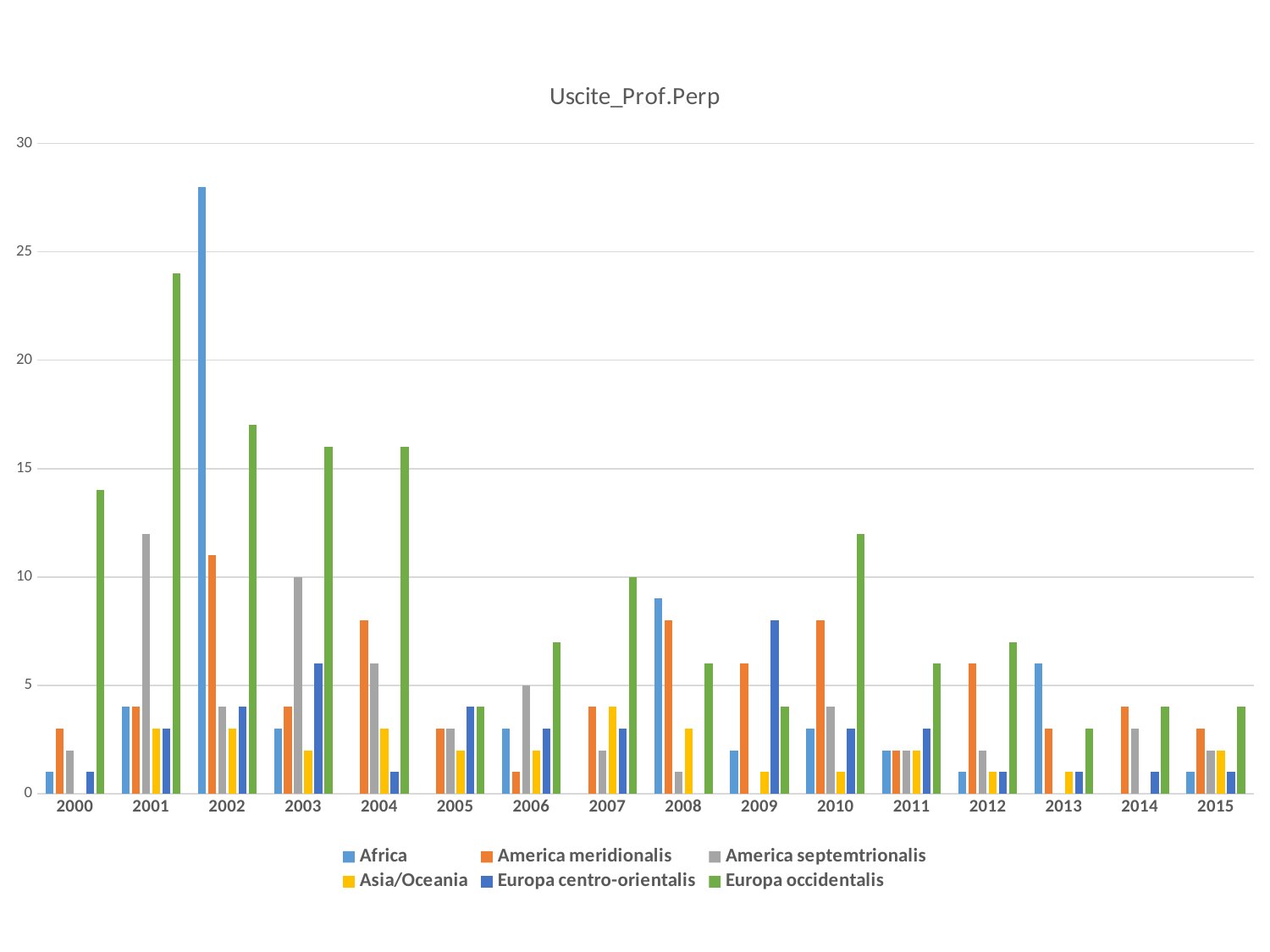
Is the value for Africa in 2002 greater or less than 25? greater Is the value for Europa centro-orientalis in 2009 greater or less than 10? less What is the title of the chart? Uscite_Prof.Perp Is the value for Europa occidentalis in 2001 greater or less than 20? greater Which is larger: Africa in 2002 or Europa occidentalis in 2001? Africa in 2002 Which series has the highest bar in 2000? Europa occidentalis Does the Europa occidentalis value rise or fall from 2001 to 2002? fall Which series has the highest bar in 2002? Africa How many series does the legend list? 6 How many years are shown on the x axis? 16 What type of chart is shown on the slide? bar chart In which year is the Europa occidentalis bar highest? 2001